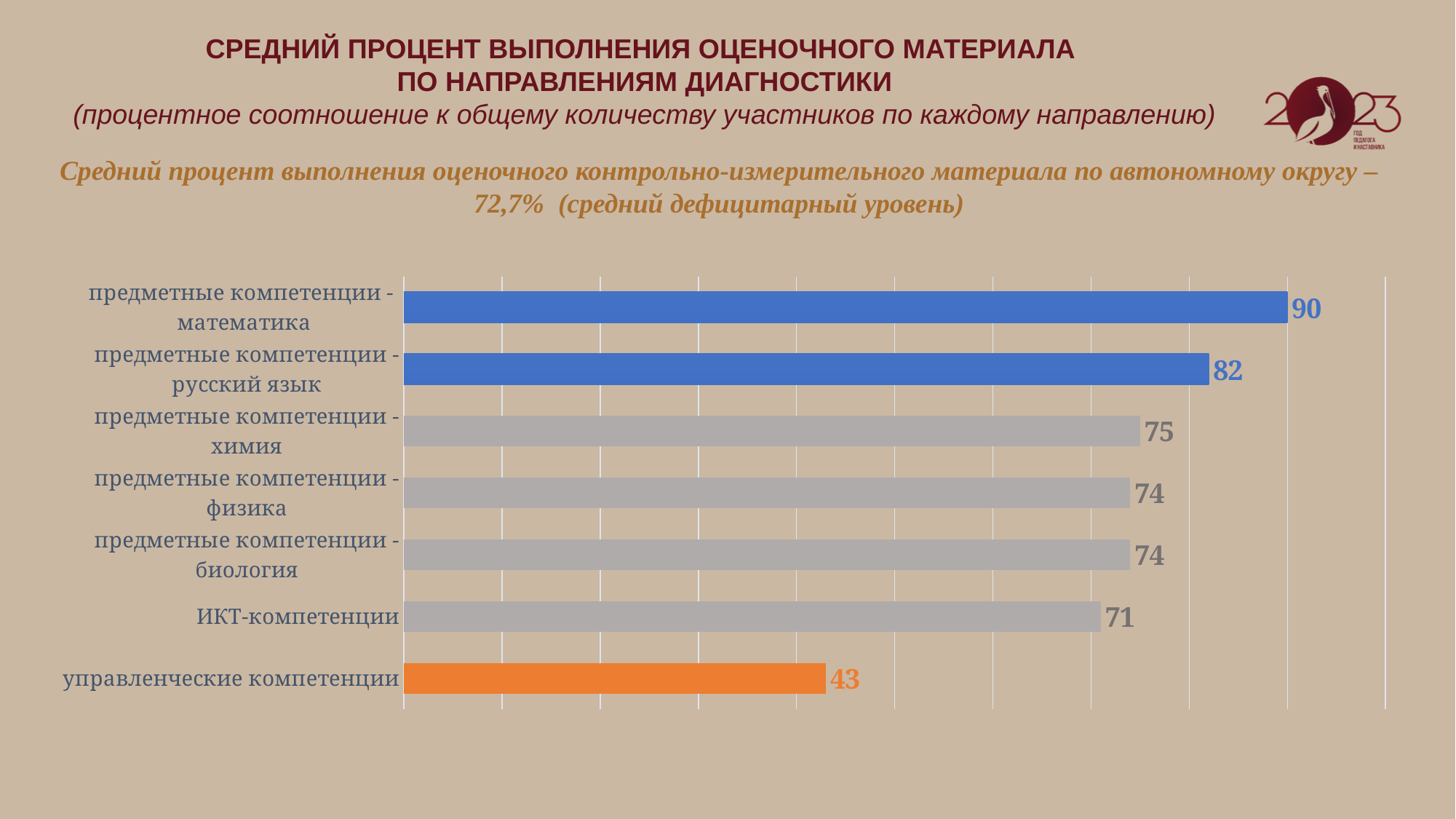
Which category has the lowest value? управленческие компетенции What is the value for предметные компетенции - математика? 90 What is the difference between the values for предметные компетенции - математика and предметные компетенции - русский язык? 8 What kind of chart is shown on the slide? bar chart Which is larger, the value for предметные компетенции - русский язык or the value for предметные компетенции - химия? предметные компетенции - русский язык What is the value for управленческие компетенции? 43 What is the value for ИКТ-компетенции? 71 Which category has the highest value? предметные компетенции - математика What is the value for предметные компетенции - химия? 75 How many categories are shown in the chart? 7 What colour is the bar for управленческие компетенции? orange What is the difference between the values for ИКТ-компетенции and управленческие компетенции? 28